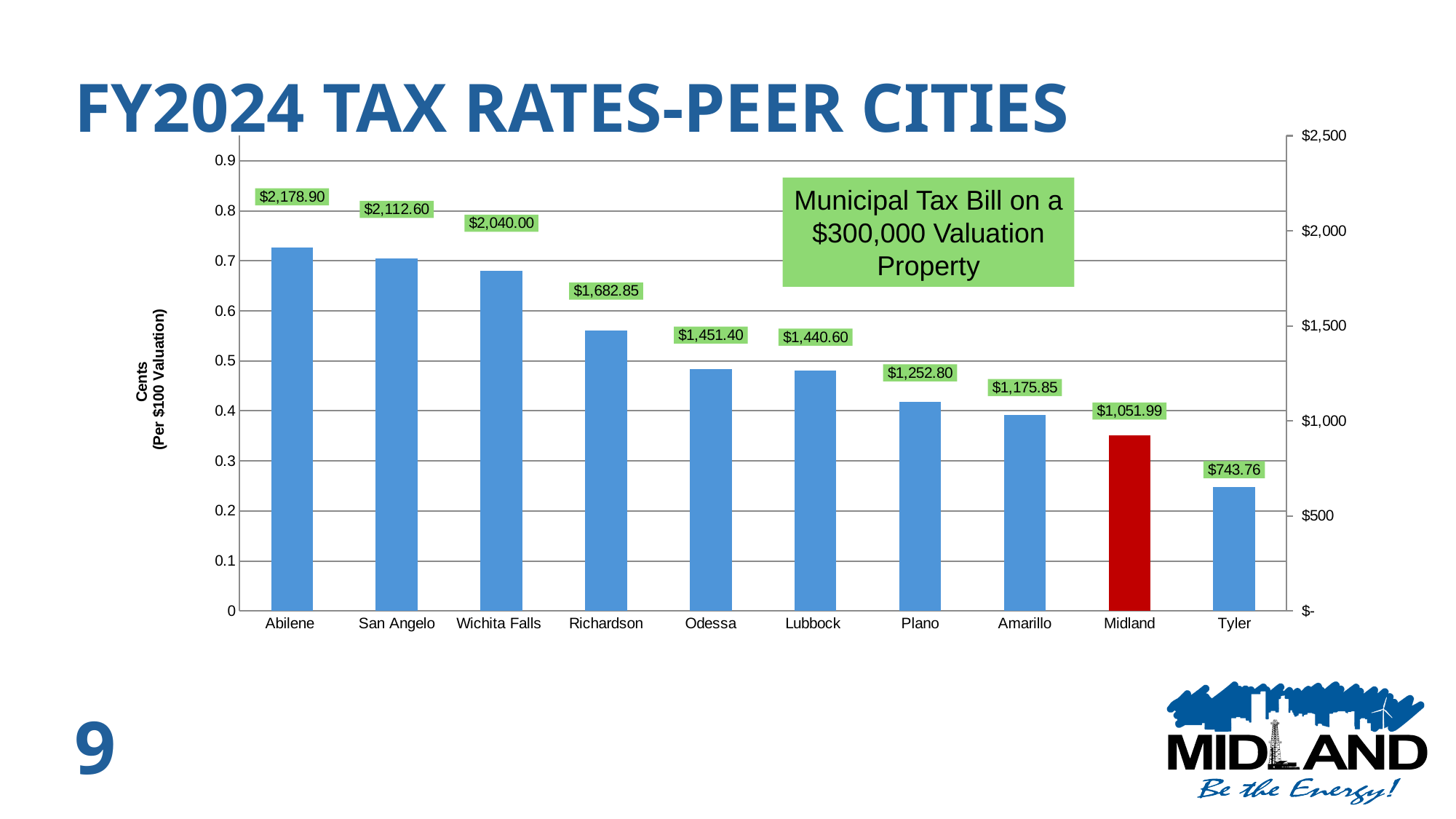
What is the municipal tax bill shown for Tyler? $743.76 Which city has the highest municipal tax bill on a $300,000 valuation property? Abilene Which city has the larger municipal tax bill, Odessa or Lubbock? Odessa What is the municipal tax bill shown for Richardson? $1,682.85 What is the municipal tax bill shown for Midland? $1,051.99 Which city has the lowest municipal tax bill on a $300,000 valuation property? Tyler How much higher is Abilene's municipal tax bill than Midland's? $1,126.91 Is the tax rate bar for Abilene greater or less than 0.7 on the left axis? greater Do the tax rate bars rise or fall from left to right across the cities? Fall How many cities are shown on the chart? 10 Is the tax rate bar for Midland greater or less than 0.4 on the left axis? less What kind of chart is shown on the slide? Bar chart